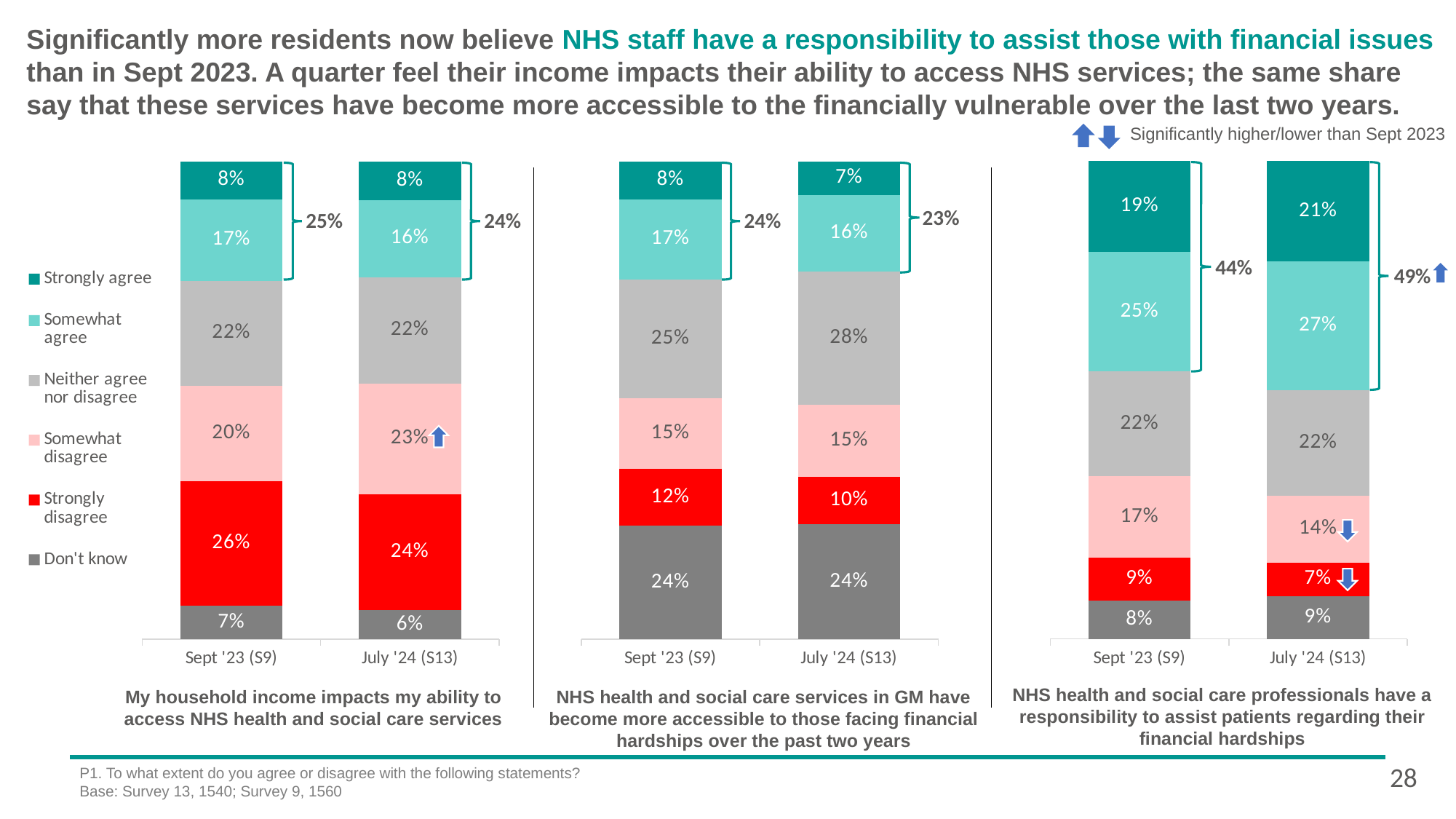
In the chart 'NHS health and social care professionals have a responsibility to assist patients regarding their financial hardships', what is the combined share of strongly agree and somewhat agree shown for July '24 (S13)? 49% In the chart 'NHS health and social care professionals have a responsibility to assist patients regarding their financial hardships', what percentage strongly agreed in July '24 (S13)? 21% In the chart 'NHS health and social care services in GM have become more accessible to those facing financial hardships over the past two years', which is larger: the 'Neither agree nor disagree' share in Sept '23 (S9) or in July '24 (S13)? July '24 (S13) In the chart 'NHS health and social care professionals have a responsibility to assist patients regarding their financial hardships', by how many percentage points did the combined agree share change from Sept '23 (S9) to July '24 (S13)? 5 percentage points In the chart 'NHS health and social care professionals have a responsibility to assist patients regarding their financial hardships', which response category has the smallest share in July '24 (S13)? Strongly disagree In the chart 'My household income impacts my ability to access NHS health and social care services', what percentage somewhat disagreed in July '24 (S13)? 23% What type of chart is used on this slide? Stacked bar chart How many response categories does the legend list? 6 In the chart 'My household income impacts my ability to access NHS health and social care services', what is the difference between the strongly disagree shares in Sept '23 (S9) and July '24 (S13)? 2 percentage points In the chart 'My household income impacts my ability to access NHS health and social care services', what percentage strongly disagreed in Sept '23 (S9)? 26% How many bars are shown in each of the three charts? 2 In the chart 'NHS health and social care services in GM have become more accessible to those facing financial hardships over the past two years', what percentage answered 'Don't know' in July '24 (S13)? 24%